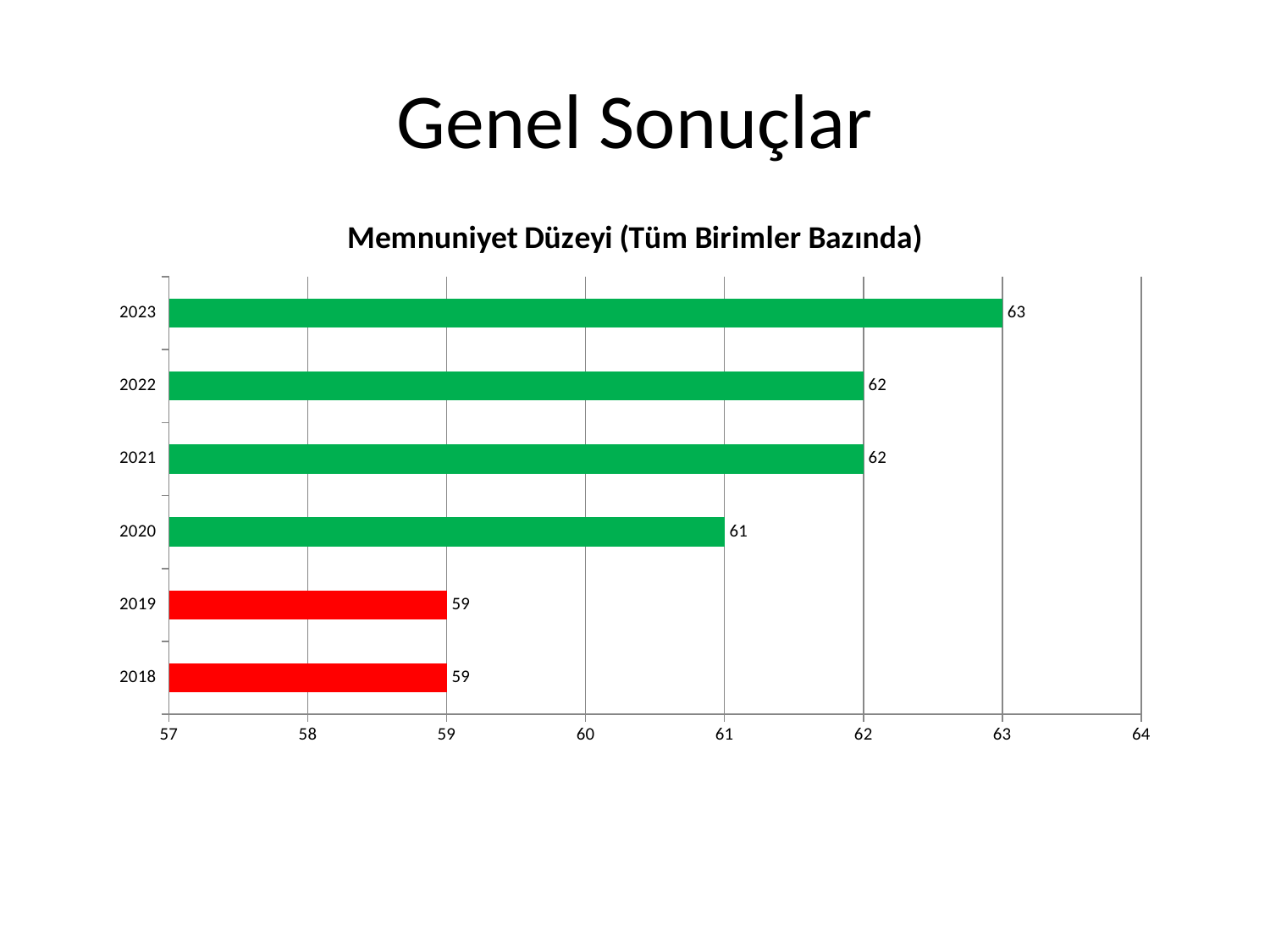
What is the difference between the values for 2023 and 2018? 4 Do the values rise or fall from 2018 to 2023? rise What kind of chart is shown? bar chart What is the value for 2018? 59 What is the value for 2020? 61 Is the value for 2021 greater or less than 60? greater What is the title of the chart? Memnuniyet Düzeyi (Tüm Birimler Bazında) What is the difference between the values for 2022 and 2020? 1 Which is larger, the value for 2020 or the value for 2019? 2020 Which year has the highest value? 2023 How many years are shown in the chart? 6 What is the value for 2023? 63